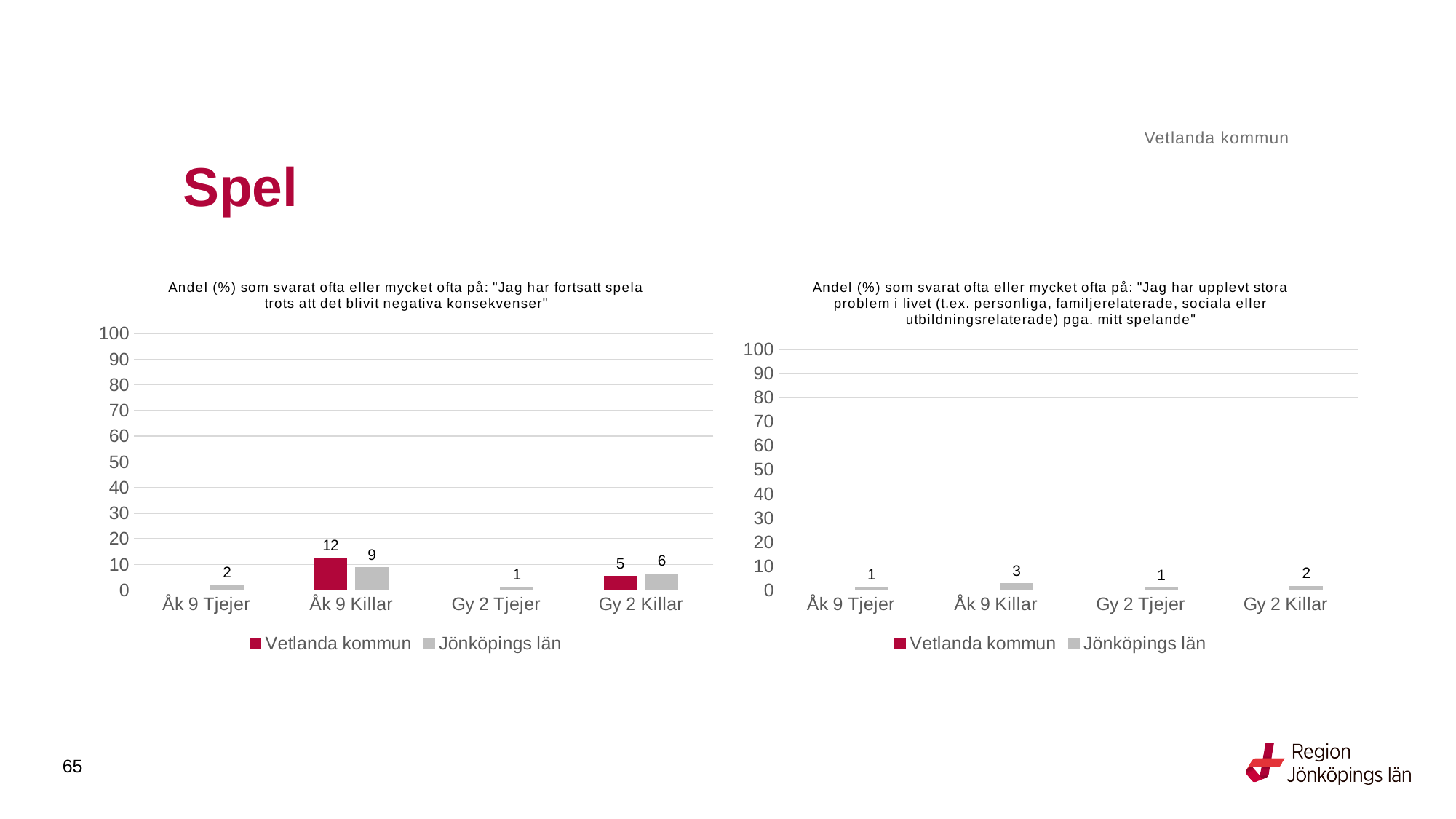
In the left chart, what is the difference between Vetlanda kommun and Jönköpings län for Åk 9 Killar? 3 In the left chart, which category has the highest value for Jönköpings län? Åk 9 Killar How many categories are shown on the x axis of the right chart? 4 In the right chart, what is the value for Jönköpings län for Åk 9 Killar? 3 In the right chart, which category has the highest value for Jönköpings län? Åk 9 Killar In the left chart, what is the value for Jönköpings län for Gy 2 Killar? 6 In the left chart, for Gy 2 Killar, which is larger: Vetlanda kommun or Jönköpings län? Jönköpings län In the left chart, what is the value for Jönköpings län for Åk 9 Tjejer? 2 In the left chart, is the value for Vetlanda kommun for Åk 9 Killar greater or less than 10? greater How many series does the legend of the left chart list? 2 In the left chart, what is the value for Vetlanda kommun for Åk 9 Killar? 12 In the right chart, what is the value for Jönköpings län for Gy 2 Killar? 2